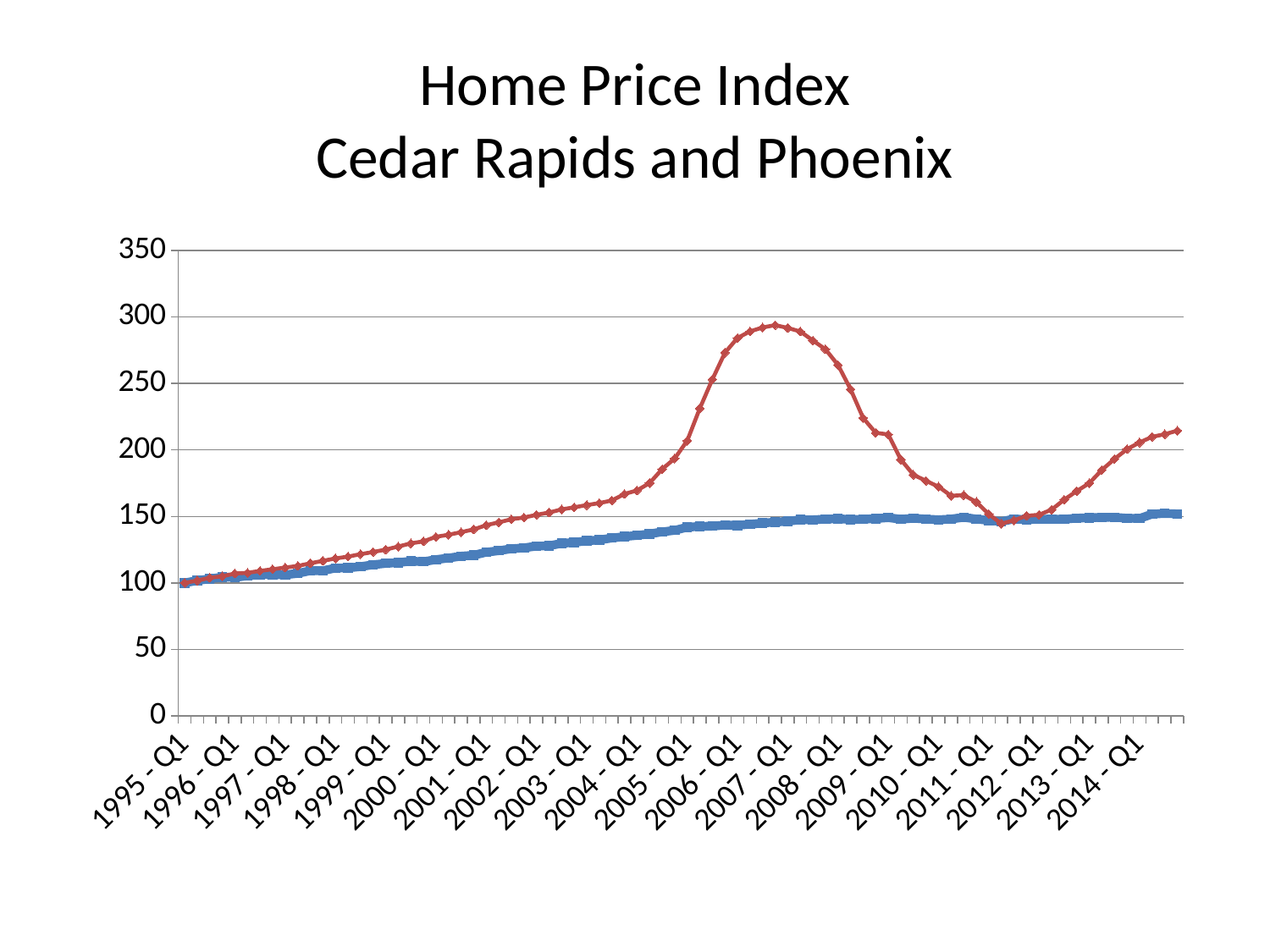
How many lines are plotted on the chart? 2 Which line has the higher value at 2008 - Q1, the red line or the blue line? red line What kind of chart is shown on the slide? line chart How many year labels (1995 - Q1 through 2014 - Q1) are shown on the x axis? 20 Is the value of the red line at 2010 - Q1 greater or less than 150? greater Does the red line rise or fall between 2007 - Q1 and 2011 - Q1? fall Is the value of the red line at 2007 - Q1 greater or less than 250? greater What value do both lines start at in 1995 - Q1? 100 What is the title of the chart? Home Price Index Cedar Rapids and Phoenix Is the value of the blue line at 2014 - Q1 greater or less than 200? less